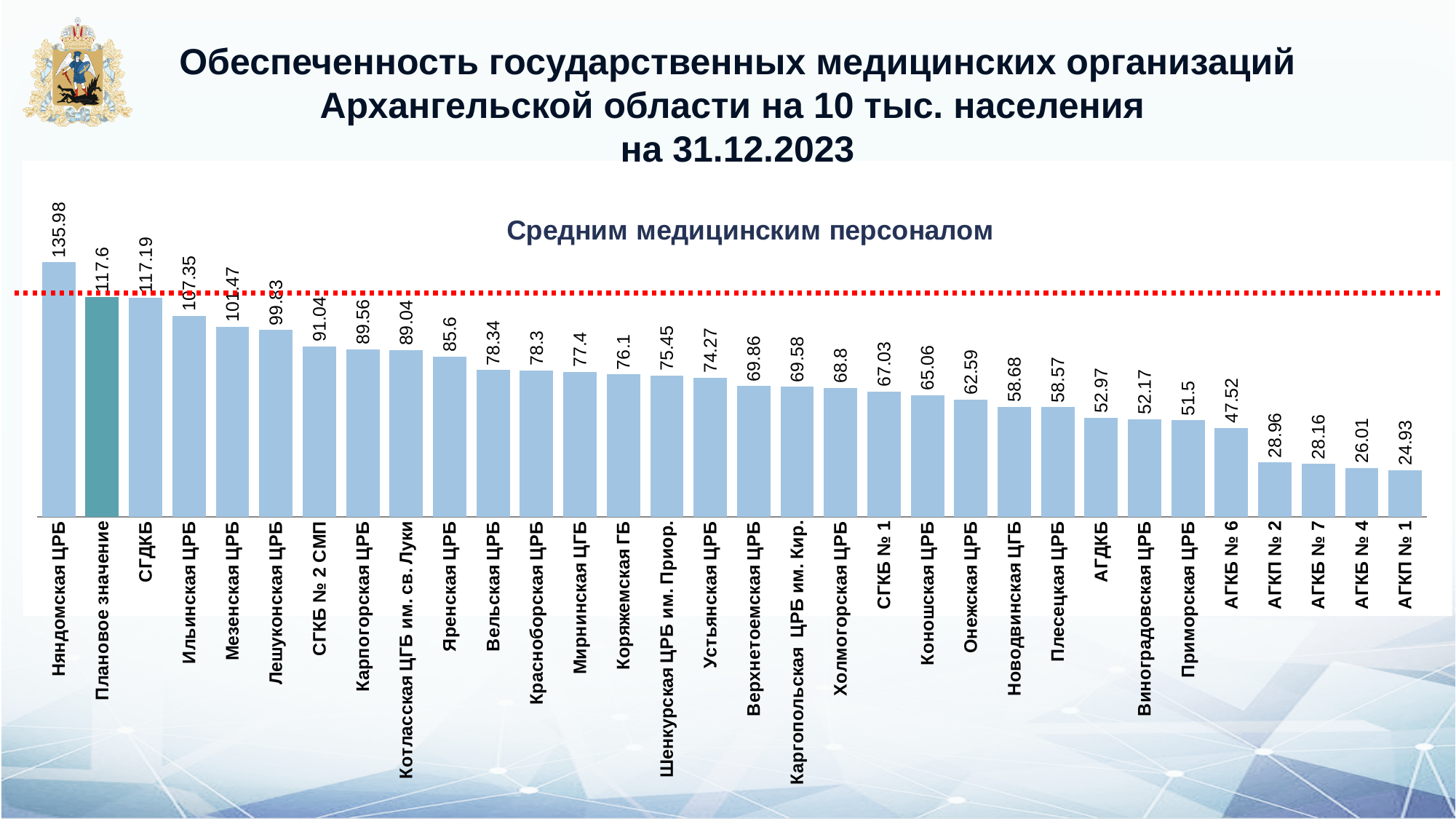
What is the value for Плановое значение? 117.6 What is the title of the chart? Средним медицинским персоналом What kind of chart is shown on the slide? Bar chart What is the difference between the values for Няндомская ЦРБ and Плановое значение? 18.38 What is the value for Няндомская ЦРБ? 135.98 What is the difference between the values for СГДКБ and Ильинская ЦРБ? 9.84 How many bars are shown in the chart? 32 Which is larger, the value for Мезенская ЦРБ or the value for Лешуконская ЦРБ? Мезенская ЦРБ What is the value for Котласская ЦГБ им. св. Луки? 89.04 Which category has the highest value? Няндомская ЦРБ What is the value for АГКБ № 6? 47.52 Which category has the lowest value? АГКП № 1